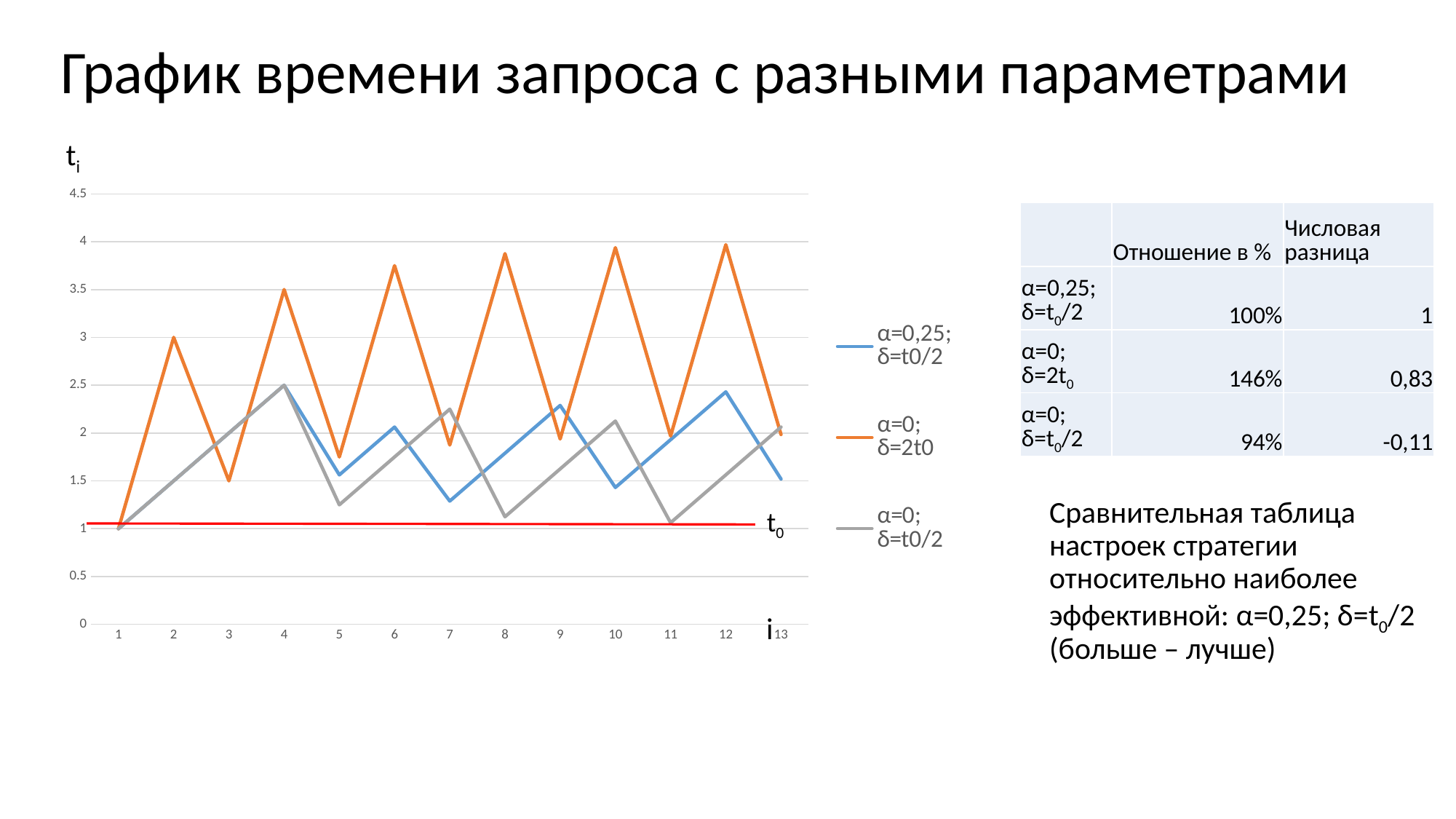
Do the peaks of the α=0; δ=2t0 series rise or fall as i increases? rise Which series reaches the highest values on the chart? α=0; δ=2t0 What colour is the line for the α=0; δ=2t0 series? orange Is the value of the α=0; δ=t0/2 series at i=8 greater or less than 1.5? less How many series does the chart legend list? 3 Is the value of the α=0,25; δ=t0/2 series at i=7 greater or less than 1.5? less What kind of chart is shown on the slide? line chart How many points are labelled along the x axis (i) of the chart? 13 Is the value of the α=0; δ=2t0 series at i=6 greater or less than 3.5? greater At i=5, which series has the larger value: α=0,25; δ=t0/2 or α=0; δ=t0/2? α=0,25; δ=t0/2 At i=2, which series has the larger value: α=0; δ=2t0 or α=0; δ=t0/2? α=0; δ=2t0